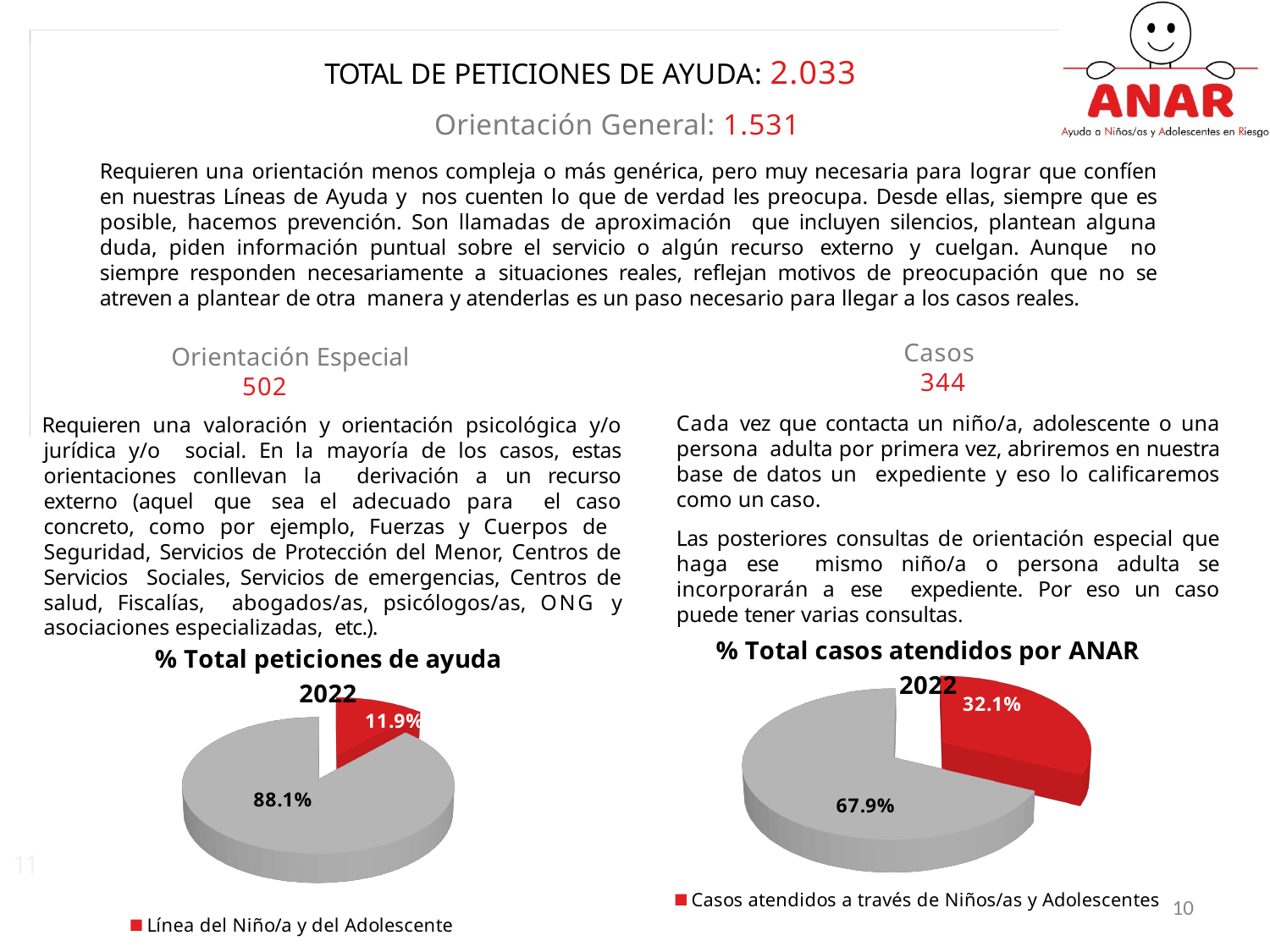
What legend entry is shown below the '% Total peticiones de ayuda 2022' chart on the left? Línea del Niño/a y del Adolescente In the '% Total peticiones de ayuda 2022' chart on the left, what share is shown for the red slice labelled 'Línea del Niño/a y del Adolescente'? 11.9% What kind of chart is the '% Total peticiones de ayuda 2022' chart on the left? pie chart In the '% Total peticiones de ayuda 2022' chart on the left, what is the difference between the grey slice and the red slice? 76.2% In the '% Total casos atendidos por ANAR 2022' chart on the right, what share is shown for the red slice labelled 'Casos atendidos a través de Niños/as y Adolescentes'? 32.1% What kind of chart is the '% Total casos atendidos por ANAR 2022' chart on the right? pie chart In the '% Total peticiones de ayuda 2022' chart on the left, which slice is larger, the red one or the grey one? the grey one Which chart has the larger red slice, the '% Total peticiones de ayuda 2022' chart on the left or the '% Total casos atendidos por ANAR 2022' chart on the right? the '% Total casos atendidos por ANAR 2022' chart on the right How many slices does the '% Total peticiones de ayuda 2022' chart on the left have? 2 In the '% Total casos atendidos por ANAR 2022' chart on the right, what is the difference between the grey slice and the red slice? 35.8% In the '% Total casos atendidos por ANAR 2022' chart on the right, what share is shown for the grey slice? 67.9% In the '% Total peticiones de ayuda 2022' chart on the left, what share is shown for the grey slice? 88.1%